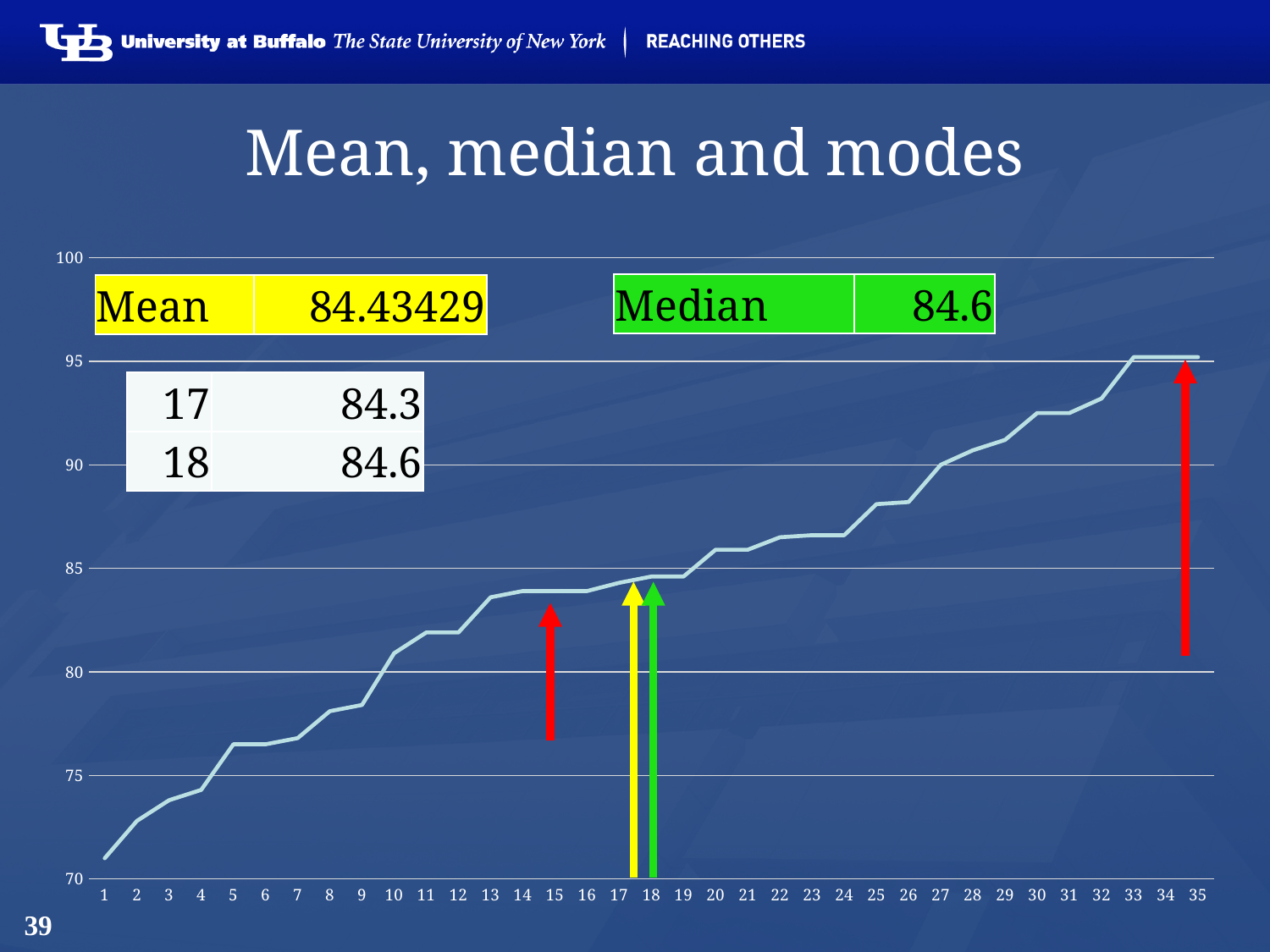
How many data points are plotted along the x axis? 35 What kind of chart is shown on the slide? line chart What is the difference between the values for points 18 and 17? 0.3 What is the value for point 17 according to the table on the slide? 84.3 Do the plotted values rise or fall as the x axis goes from 1 to 35? rise Which has the larger value, point 17 or point 18? 18 What is the mean value shown on the slide? 84.43429 What is the value for point 18 according to the table on the slide? 84.6 Is the value for point 1 greater or less than 75? less What is the median value shown on the slide? 84.6 Which point on the x axis has the lowest value? 1 Is the value for point 30 greater or less than 90? greater